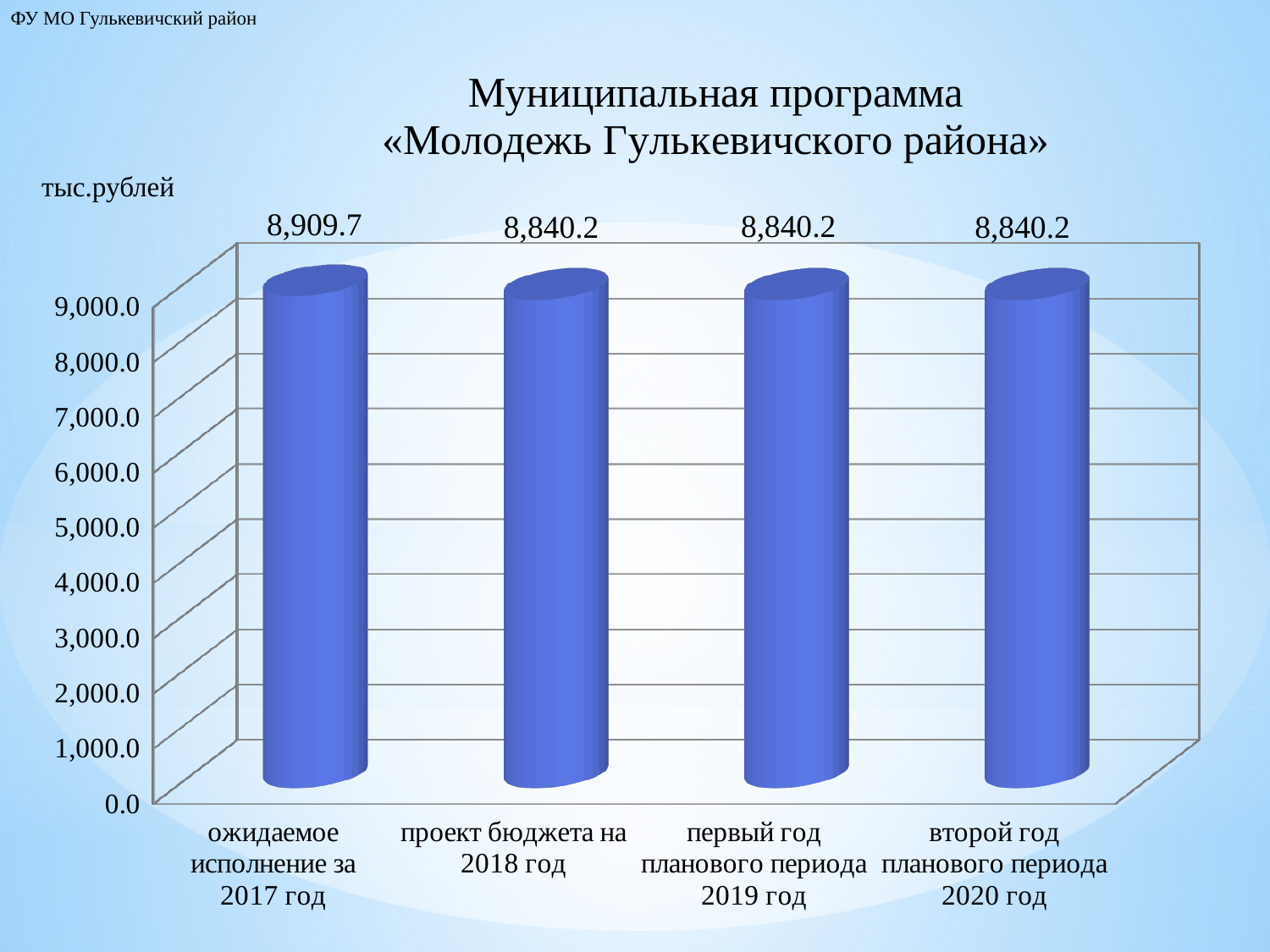
What is the value for 'второй год планового периода 2020 год'? 8,840.2 What is the difference between the value for 2017 and the value for 2018? 69.5 What is the value for 'ожидаемое исполнение за 2017 год'? 8,909.7 Do the values rise or fall from 2017 to 2018? fall Which is larger: the value for 'ожидаемое исполнение за 2017 год' or for 'первый год планового периода 2019 год'? ожидаемое исполнение за 2017 год What is the title of the chart? Муниципальная программа «Молодежь Гулькевичского района» What kind of chart is shown on the slide? bar chart Is the value for 'проект бюджета на 2018 год' greater or less than 8,000.0? greater What is the value for 'проект бюджета на 2018 год'? 8,840.2 Which category has the highest value? ожидаемое исполнение за 2017 год In what units are the values on the chart given? тыс.рублей How many categories are shown on the chart? 4